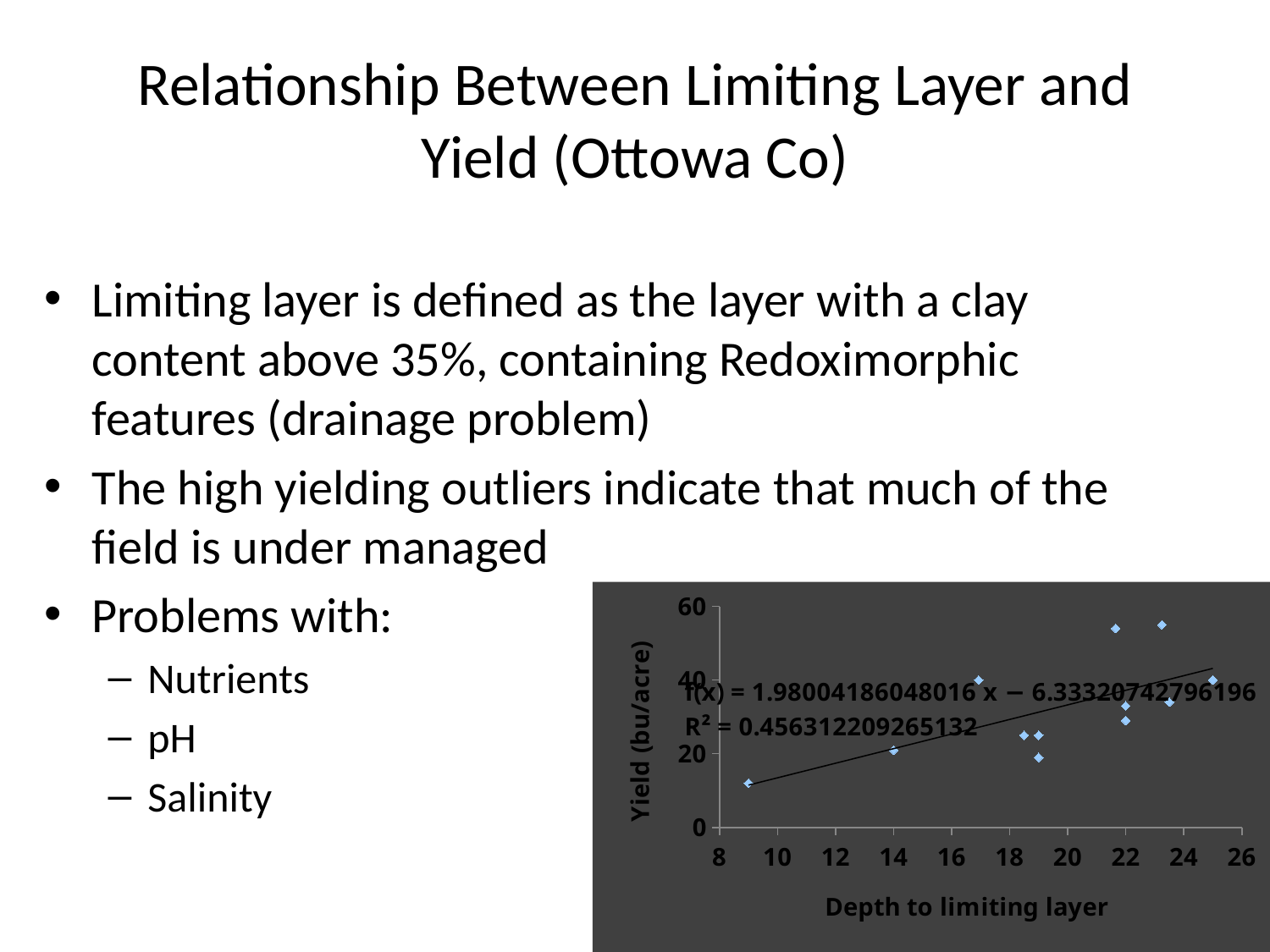
According to the trendline, does yield rise or fall as depth to limiting layer increases? rise Are the two points plotted above 50 bu/acre at depths greater or less than 20? greater Is the yield for the point at the largest depth (about 25) greater or less than 20? greater What is the R² value printed on the chart? 0.456312209265132 Which has the higher yield: the point at a depth of about 9 or the point at a depth of about 23? the point at a depth of about 23 Is the lowest yield plotted on the chart greater or less than 20? less What kind of chart is shown on the slide? scatter chart What is the title of the x axis of the chart? Depth to limiting layer